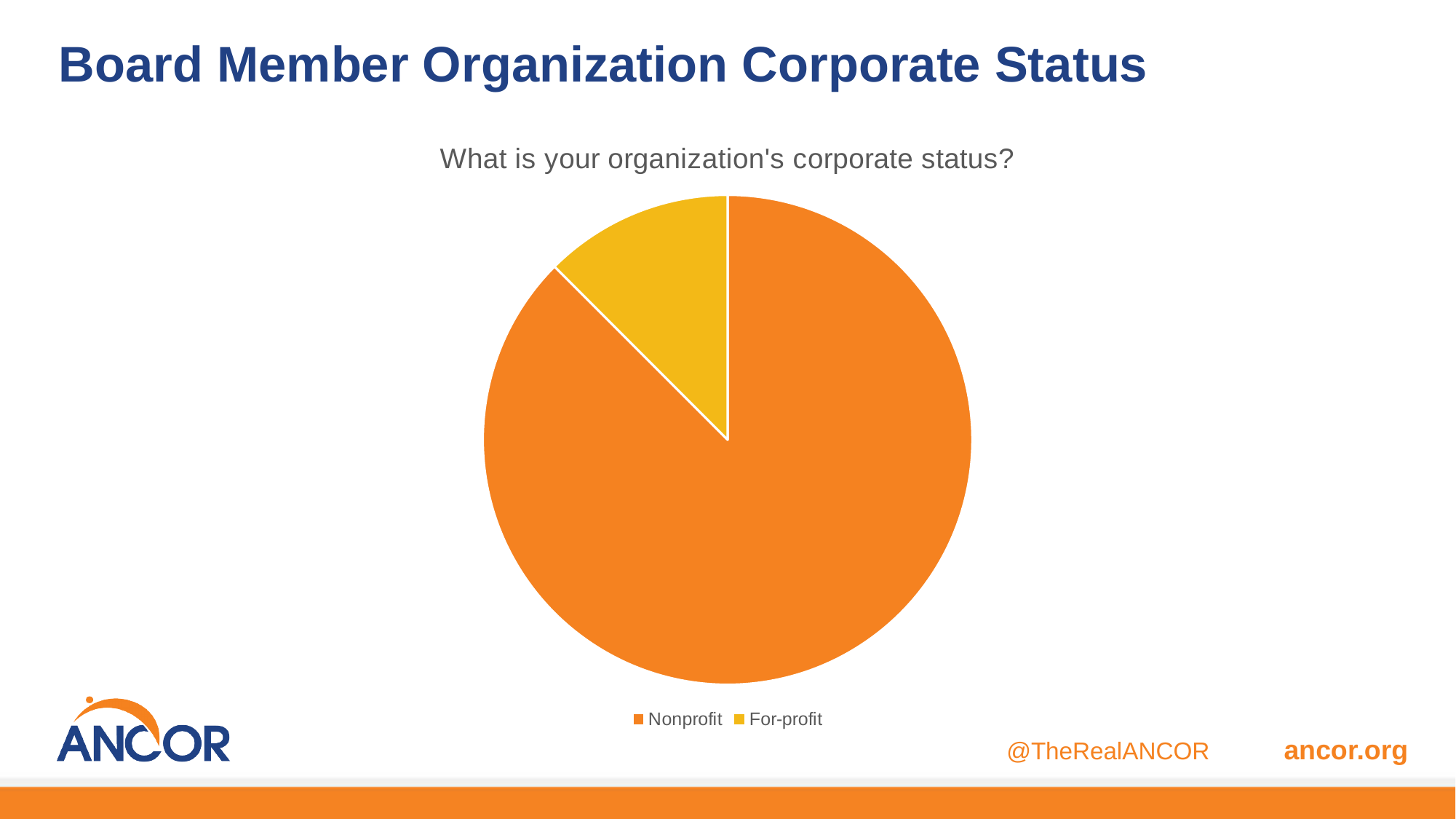
How many entries does the legend of the pie chart list? 2 How many slices does the pie chart have? 2 What colour is the For-profit slice in the pie chart? Yellow Which slice is larger, Nonprofit or For-profit? Nonprofit What kind of chart is shown on the slide? Pie chart What is the title of the pie chart? What is your organization's corporate status? Which category has the largest slice of the pie chart? Nonprofit Which category has the smallest slice of the pie chart? For-profit